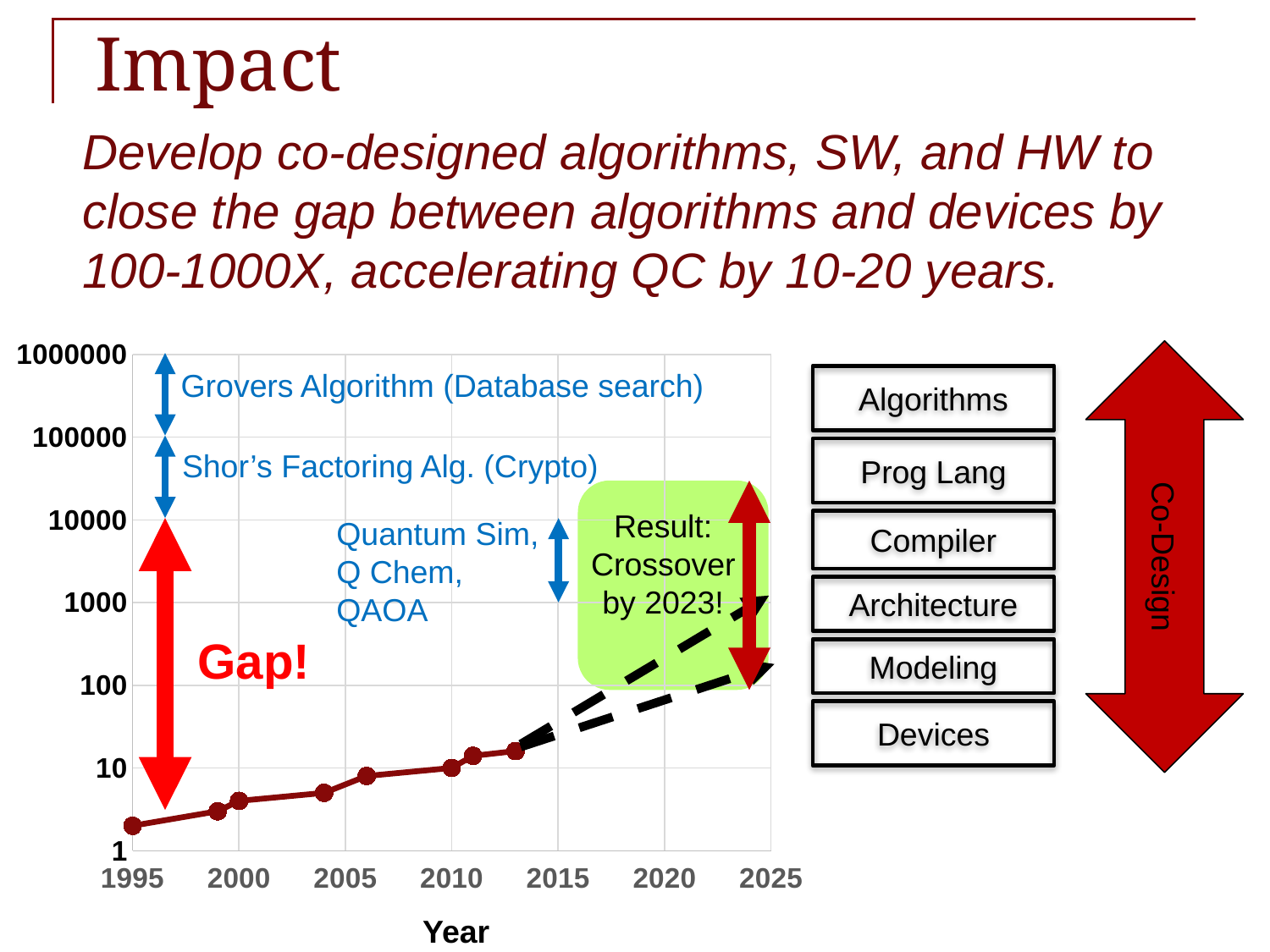
What is the title of the x axis of the chart? Year Do the plotted values rise or fall as the year increases along the x axis? rise What kind of chart is shown on the slide? line chart Is the plotted value for 2013 larger or smaller than the plotted value for 1995? larger Is the plotted value for 2013 greater or less than 10? greater Which year has the highest plotted value on the solid line? 2013 What is the highest value shown on the y axis of the chart? 1000000 Is the plotted value for 1995 greater or less than 10? less Is the plotted value for 2013 greater or less than 100? less Which year has the lowest plotted value on the solid line? 1995 How many data points are plotted on the solid line in the chart? 8